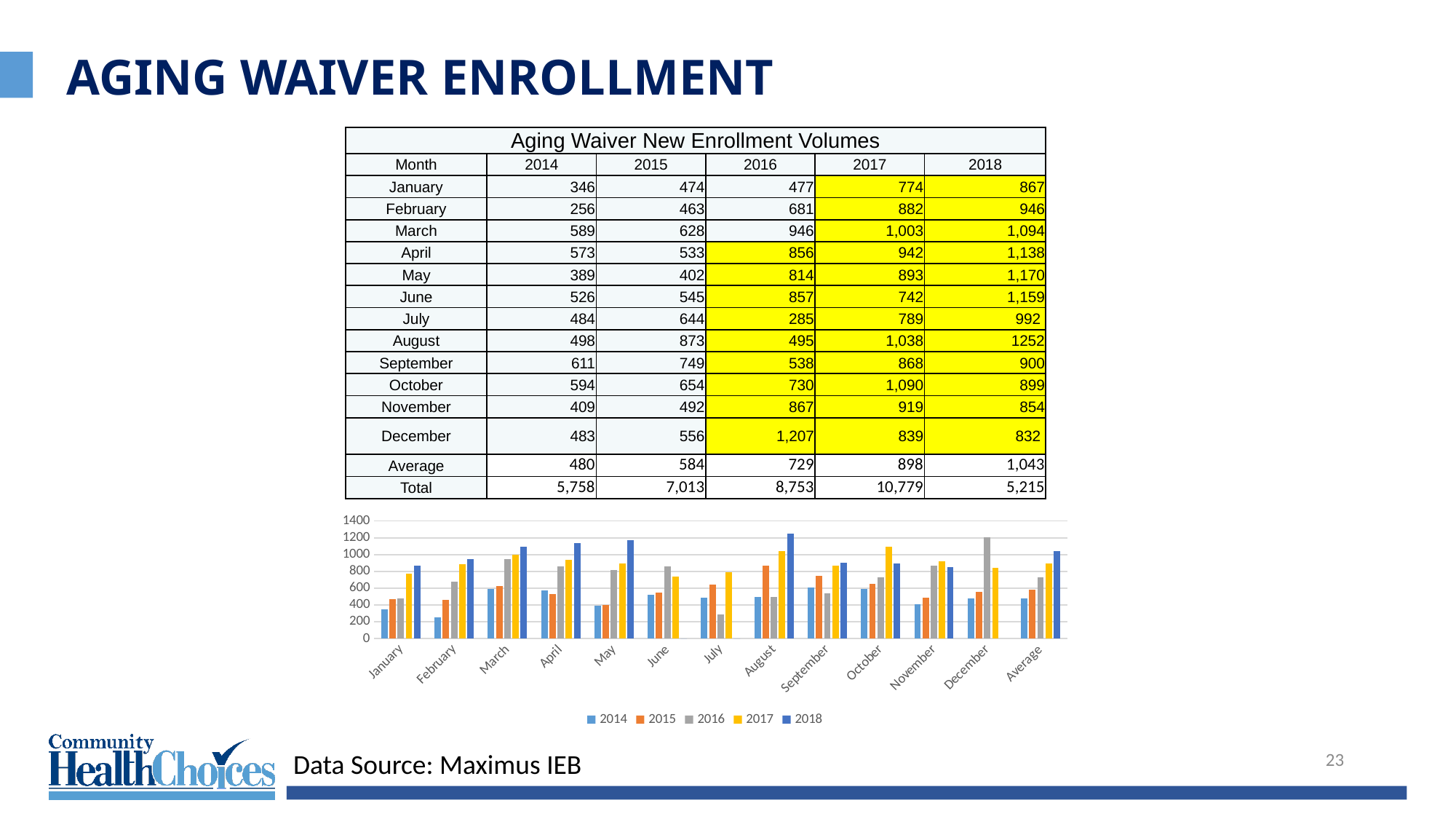
Which month has the highest 2018 bar? August Is the 2016 value for July greater or less than 400? less What is the 2018 value for August? 1252 What is the difference between the 2018 and 2014 values for January? 521 How many categories are shown along the x axis of the chart? 13 Do the Average values rise or fall from 2014 to 2018? rise What kind of chart is shown on the slide? bar chart Which month has the lowest 2016 bar? July How many series does the chart legend list? 5 Is the 2018 value for May greater or less than 1000? greater What is the Average value for 2017? 898 In December, which is larger, the 2016 value or the 2017 value? 2016